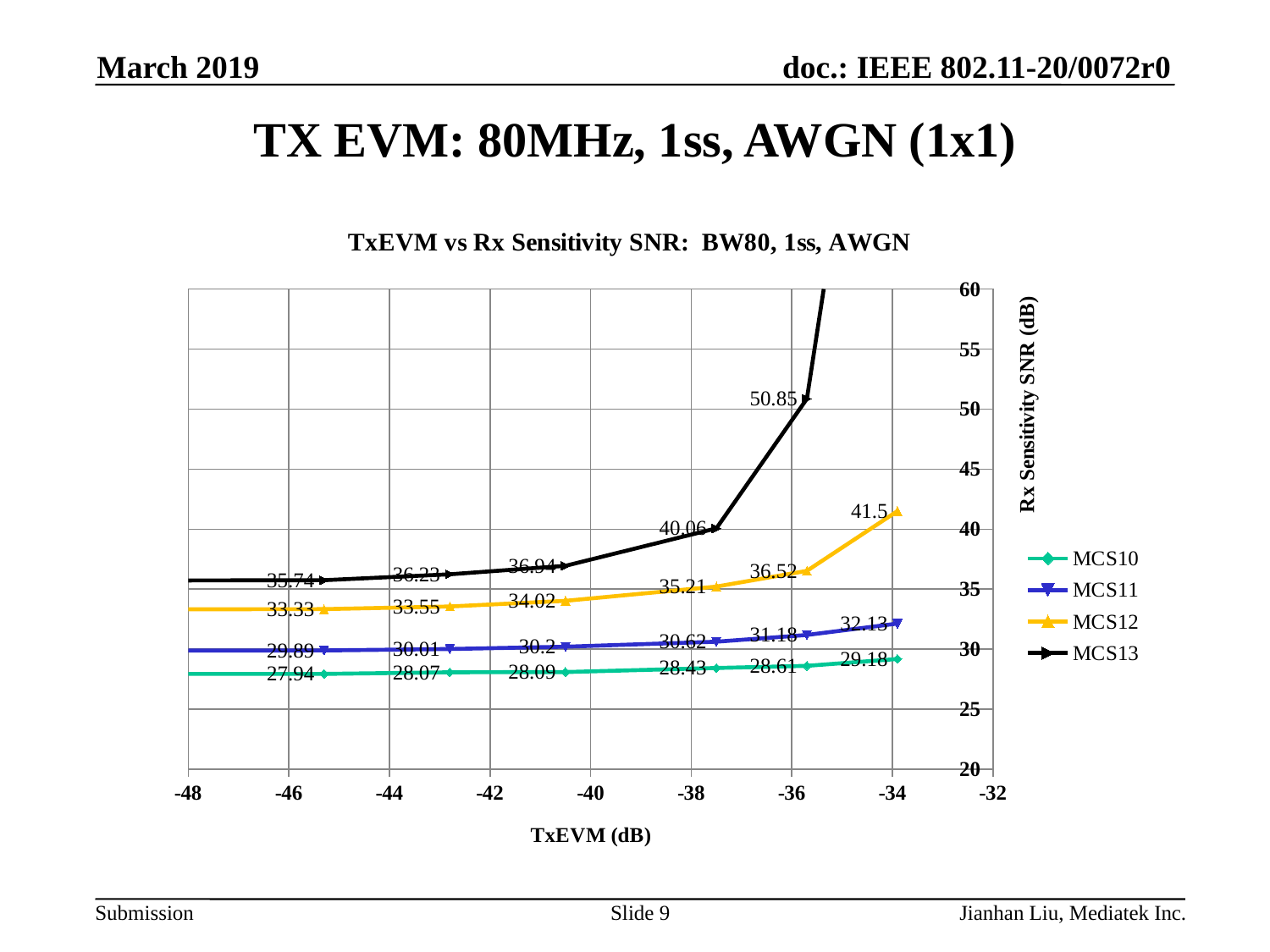
What kind of chart is shown on the slide? line chart What is the title of the x axis? TxEVM (dB) Does the MCS13 line rise or fall as TxEVM increases from left to right? rise What is the rightmost labeled value for MCS11? 32.13 What is the highest labeled value shown for MCS13? 50.85 How many series does the legend list? 4 Which series has the lowest Rx Sensitivity SNR values across the chart? MCS10 How many labeled data points does the MCS10 series have? 6 What is the difference between the rightmost and leftmost labeled values for MCS11 (32.13 and 29.89)? 2.24 At the rightmost labeled point, which series has the larger value, MCS12 or MCS11? MCS12 What is the rightmost labeled value for MCS12? 41.5 What is the leftmost labeled Rx Sensitivity SNR value for MCS10? 27.94